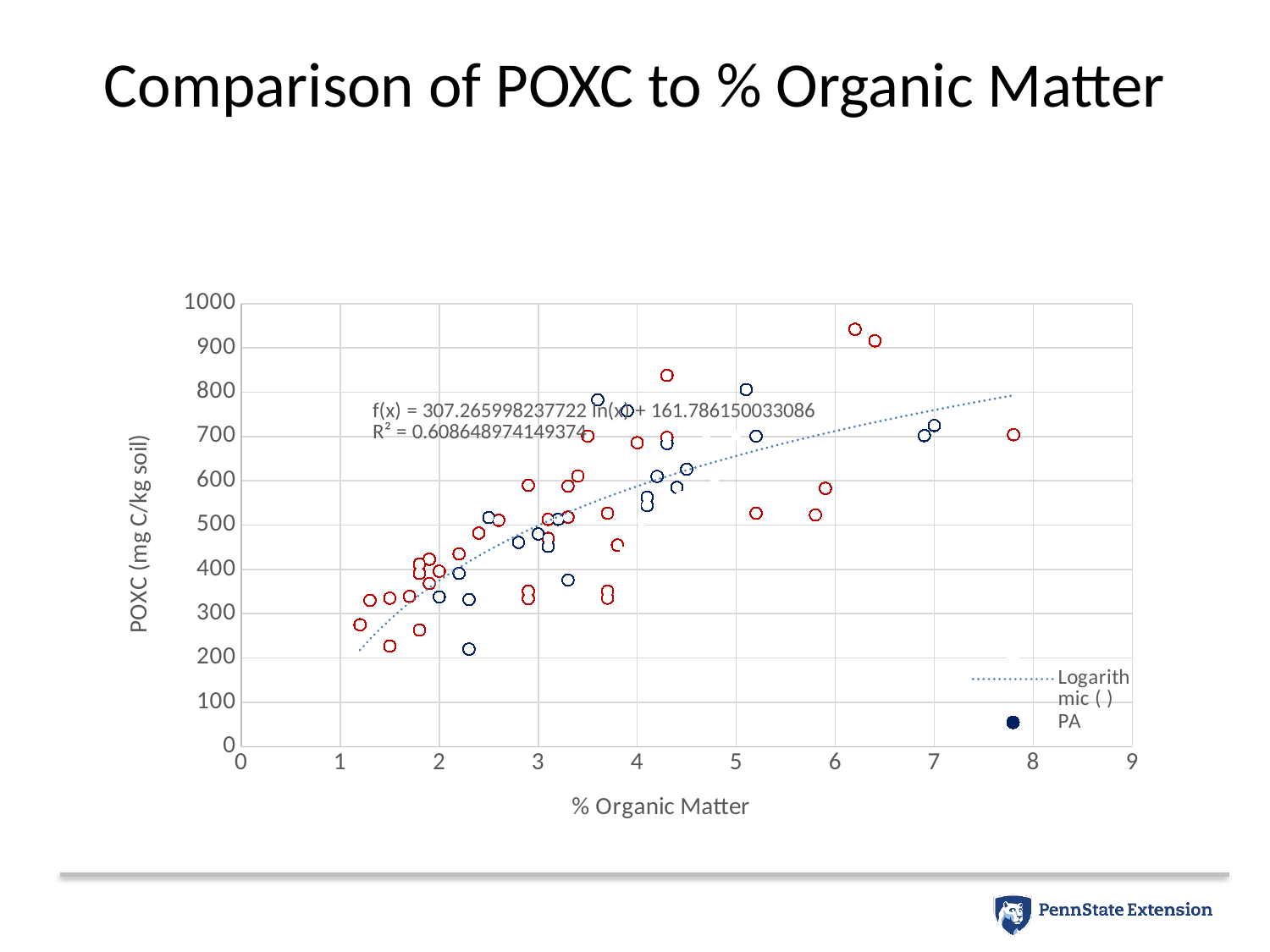
What equation is printed on the chart for the fitted trendline? f(x) = 307.265998237722 ln(x) + 161.786150033086 What is the label of the x axis? % Organic Matter What is the maximum value shown on the y axis? 1000 What kind of chart is shown on the slide? Scatter chart Is the POXC value of the lowest plotted point (near 2.3% organic matter) greater or less than 300? less What is the title of the chart? Comparison of POXC to % Organic Matter What R² value is printed on the chart for the trendline? R² = 0.608648974149374 Is the POXC value of the highest plotted point (near 6.2% organic matter) greater or less than 900? greater Does POXC generally rise or fall as % Organic Matter increases along the x axis? Rise How many entries does the legend list? 2